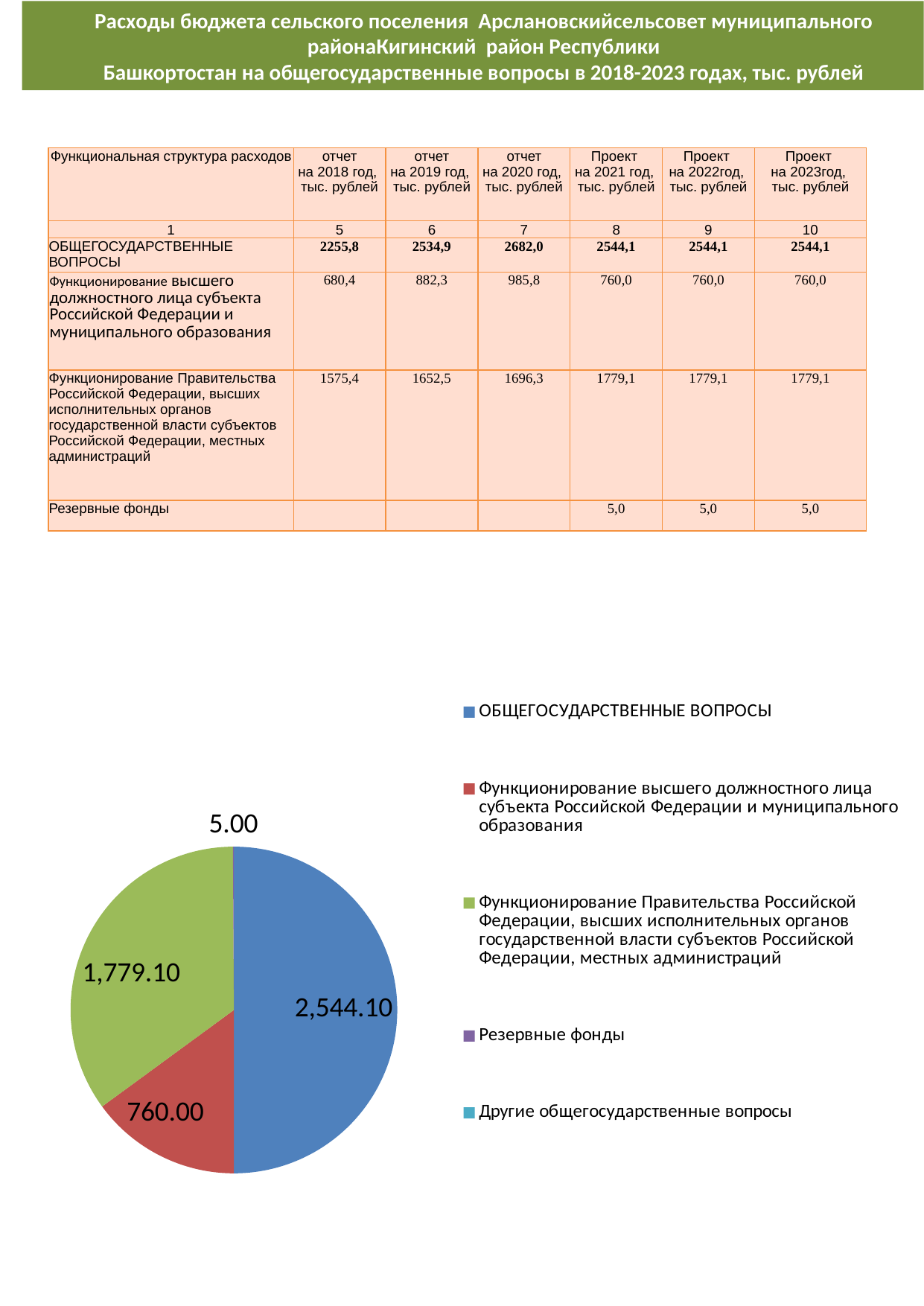
What value is shown on the pie chart for ОБЩЕГОСУДАРСТВЕННЫЕ ВОПРОСЫ? 2,544.10 What value is shown on the pie chart for Функционирование Правительства Российской Федерации, высших исполнительных органов государственной власти субъектов Российской Федерации, местных администраций? 1,779.10 What is the difference between the pie chart values 1,779.10 and 760.00? 1,019.10 What colour is the legend marker for Резервные фонды in the pie chart? purple What value is shown on the pie chart for Функционирование высшего должностного лица субъекта Российской Федерации и муниципального образования? 760.00 What is the difference between the pie chart values 2,544.10 and 1,779.10? 765.00 Which category has the largest slice in the pie chart? ОБЩЕГОСУДАРСТВЕННЫЕ ВОПРОСЫ What kind of chart is shown on the slide? pie chart What value is shown on the pie chart for Резервные фонды? 5.00 In the pie chart, which is larger: the value for Функционирование Правительства Российской Федерации... (green) or the value for Функционирование высшего должностного лица... (red)? Функционирование Правительства Российской Федерации... (green) Which labelled category has the smallest value in the pie chart? Резервные фонды How many entries does the pie chart legend list? 5